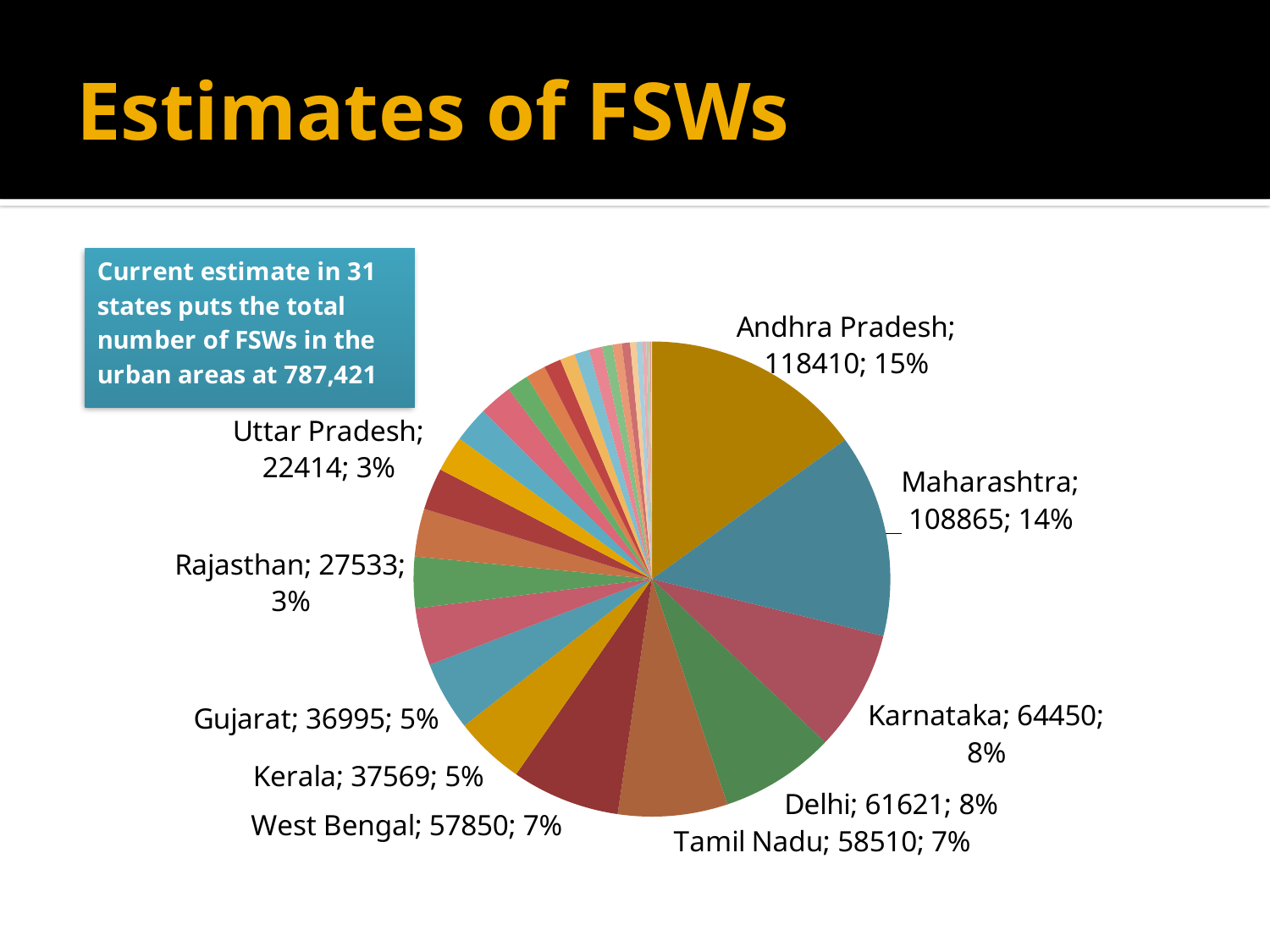
What share of the pie does Maharashtra account for? 14% What is the estimated number of FSWs for Maharashtra? 108865 What is the estimated number of FSWs for Karnataka? 64450 What kind of chart is shown on the slide? pie chart What is the estimated number of FSWs for Andhra Pradesh? 118410 What is the difference between the values for Andhra Pradesh and Maharashtra? 9545 What is the difference between the values for Karnataka and Delhi? 2829 What share of the pie does West Bengal account for? 7% What is the estimated number of FSWs for Tamil Nadu? 58510 Which has a larger value, Kerala or Gujarat? Kerala What is the estimated number of FSWs for Uttar Pradesh? 22414 Which state has the largest slice of the pie? Andhra Pradesh